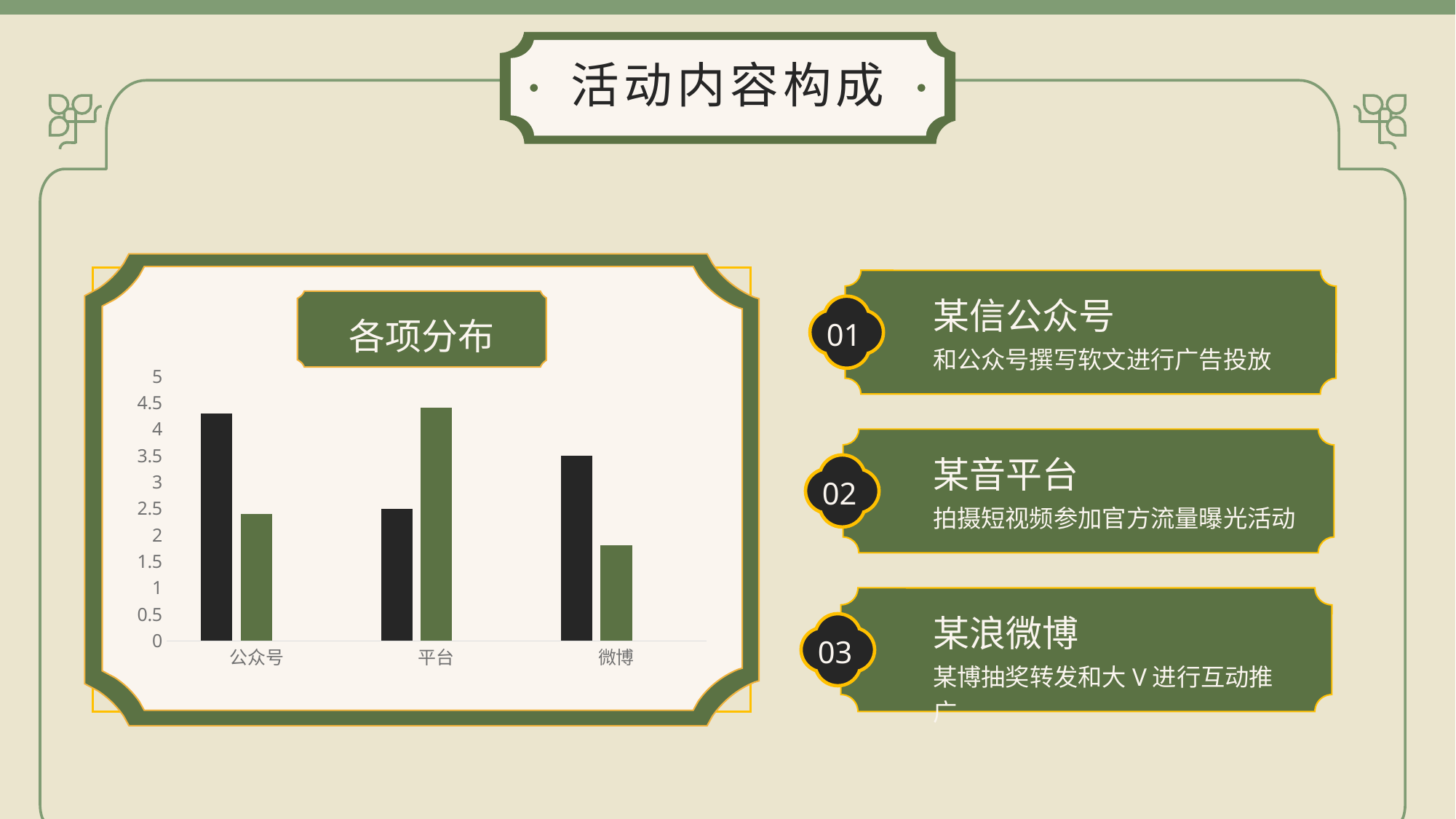
For 公众号, which bar is taller, the black one or the green one? the black one For 平台, which bar is taller, the black one or the green one? the green one How many bars are plotted for each category in the chart? 2 How many categories are shown on the x axis of the chart? 3 Which category has the shortest green bar? 微博 Which category has the tallest black bar? 公众号 Is the value of the green bar for 微博 greater or less than 2? less Is the value of the black bar for 公众号 greater or less than 4? greater Is the value of the green bar for 公众号 greater or less than 3? less What kind of chart is shown on the slide? bar chart What is the title of the chart? 各项分布